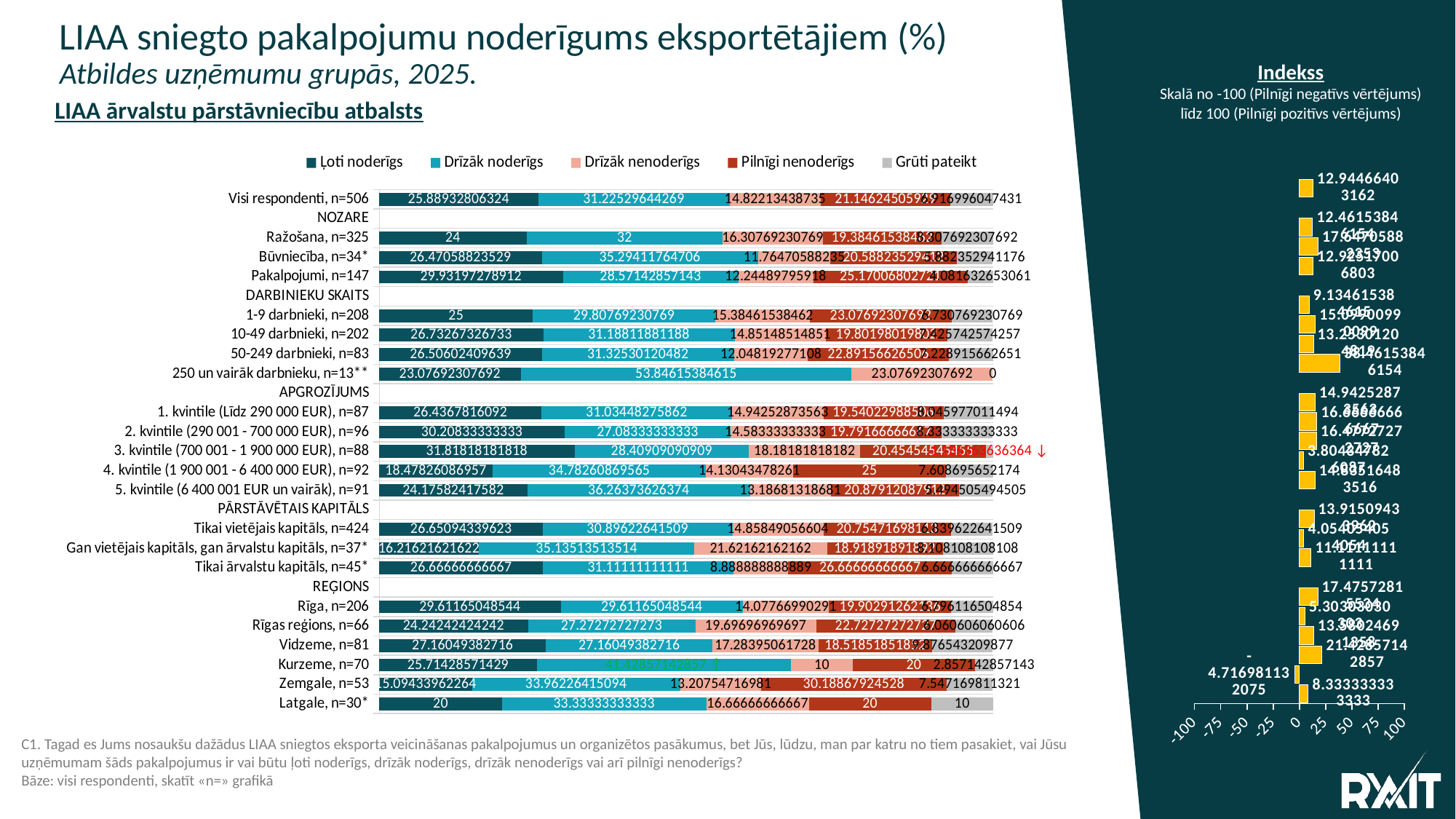
In the Indekss chart on the right, is the value for 250 un vairāk darbinieku, n=13** greater or less than 25? greater In the Indekss chart on the right, is the value for Zemgale, n=53 greater or less than 0? less In the stacked bar chart, what is the 'Drīzāk noderīgs' value for Kurzeme, n=70? 41.42857142857 In the stacked bar chart, which group has the highest 'Drīzāk noderīgs' value? 250 un vairāk darbinieku, n=13** In the stacked bar chart, what is the difference between the 'Drīzāk noderīgs' and 'Ļoti noderīgs' values for Ražošana, n=325? 8 What kind of chart is the main chart on the slide? Stacked bar chart In the stacked bar chart, what is the 'Grūti pateikt' value for Latgale, n=30*? 10 In the stacked bar chart, what is the 'Ļoti noderīgs' value for Ražošana, n=325? 24 In the stacked bar chart, what is the 'Drīzāk noderīgs' value for 250 un vairāk darbinieku, n=13**? 53.84615384615 In the stacked bar chart, which is larger: the 'Drīzāk noderīgs' value for Kurzeme, n=70 or for Latgale, n=30*? Kurzeme, n=70 How many series does the legend of the stacked bar chart list? 5 How many groups are listed under REĢIONS in the stacked bar chart? 6